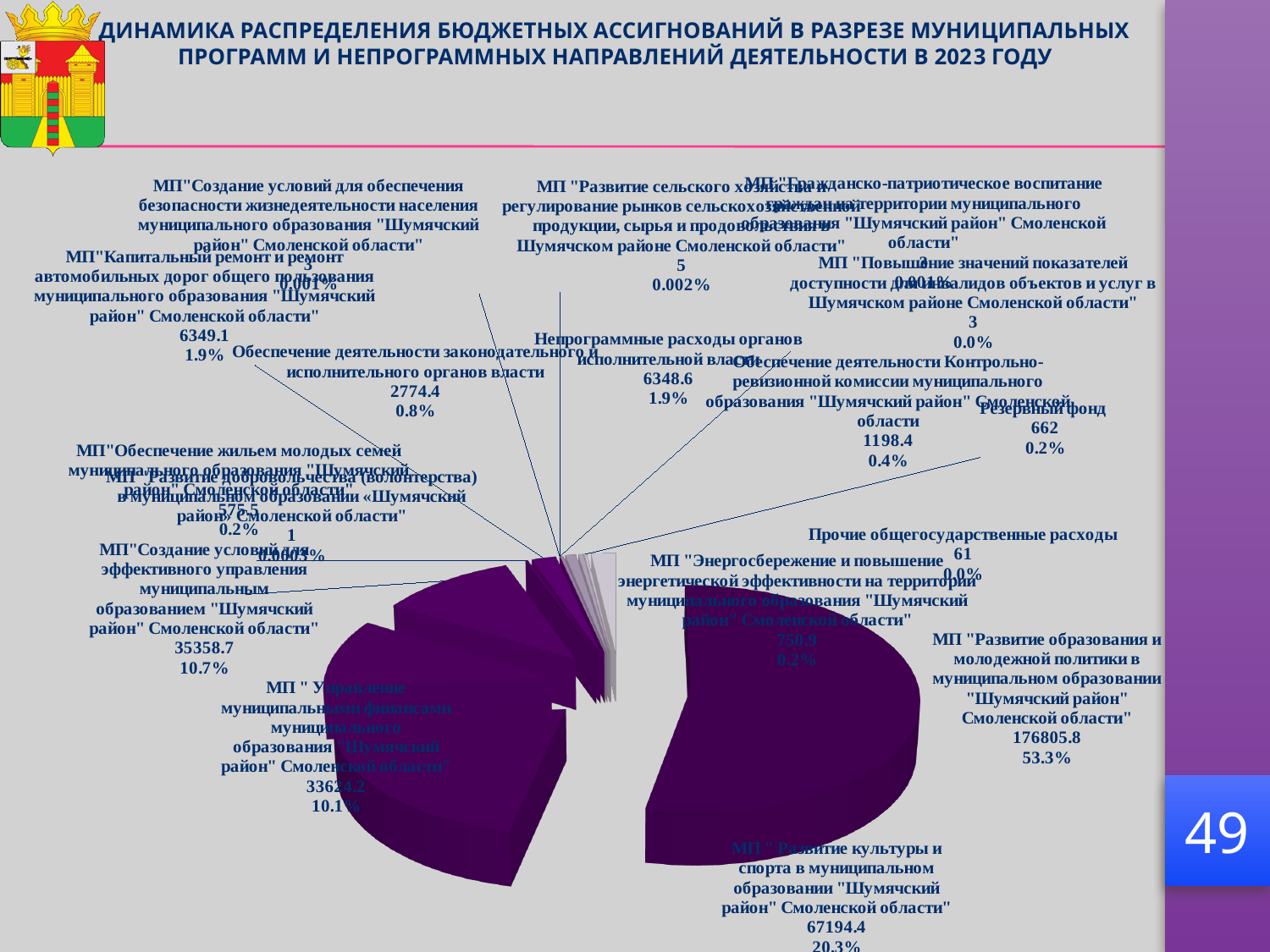
What value is shown for МП "Развитие образования и молодежной политики"? 176805.8 What share of the pie does МП "Развитие культуры и спорта" have? 20.3% What kind of chart is shown on the slide? pie chart What value is shown for МП "Развитие культуры и спорта"? 67194.4 Which is larger: the value for МП "Развитие культуры и спорта" or for МП "Создание условий для эффективного управления муниципальным образованием"? МП "Развитие культуры и спорта" Which category has the largest share of the pie? МП "Развитие образования и молодежной политики в муниципальном образовании "Шумячский район" Смоленской области" What value is shown for Непрограммные расходы органов исполнительной власти? 6348.6 What is the difference between the values for МП "Развитие образования и молодежной политики" and МП "Развитие культуры и спорта"? 109611.4 What value is shown for Обеспечение деятельности Контрольно-ревизионной комиссии? 1198.4 What share of the pie does МП "Создание условий для эффективного управления муниципальным образованием" have? 10.7% What year does the slide title say the budget allocation dynamics refer to? 2023 What value is shown for Резервный фонд? 662